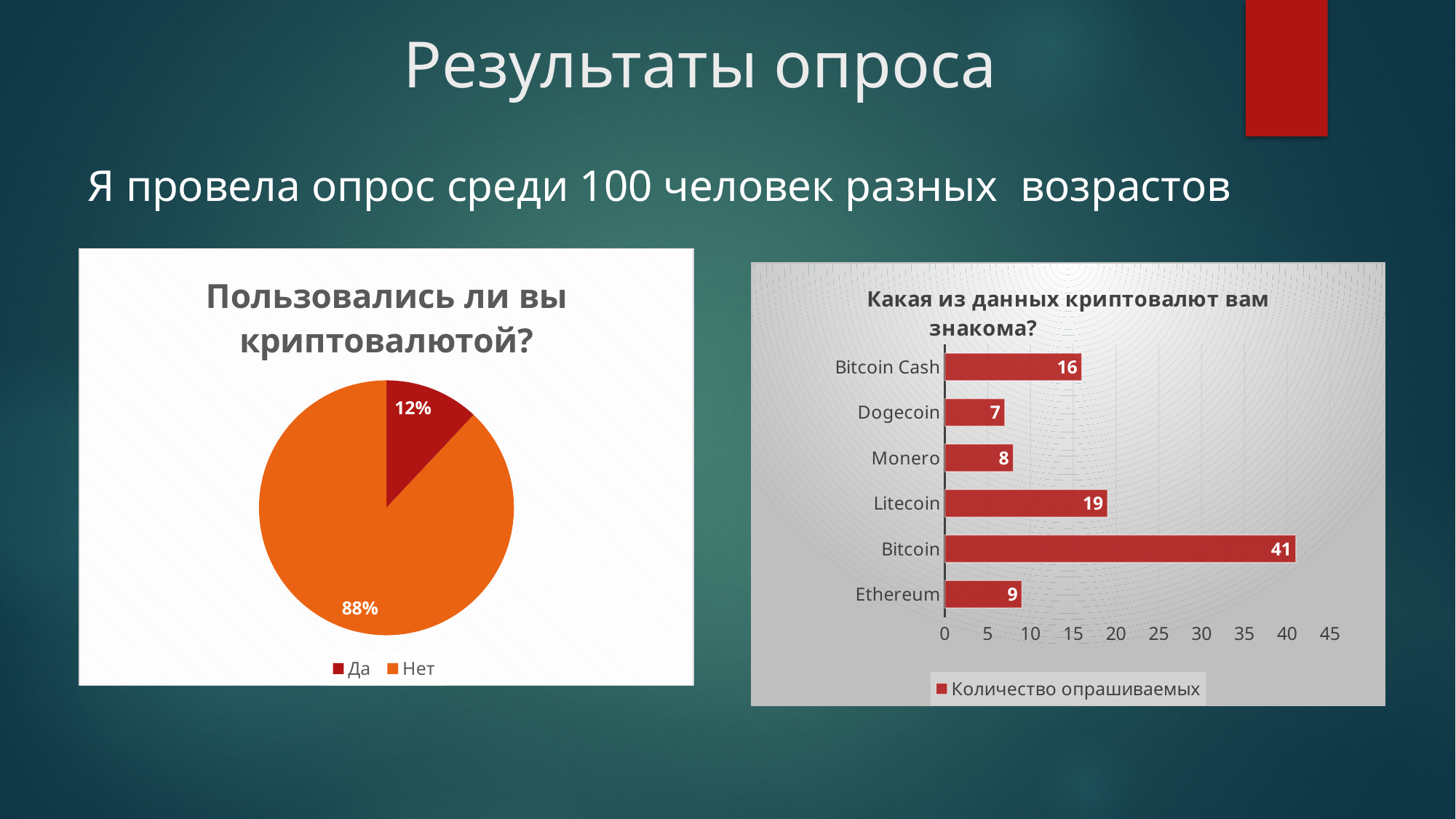
In the pie chart 'Пользовались ли вы криптовалютой?', what share of respondents answered 'Нет'? 88% In the pie chart 'Пользовались ли вы криптовалютой?', which answer has the larger slice, 'Да' or 'Нет'? Нет In the bar chart 'Какая из данных криптовалют вам знакома?', which cryptocurrency has the highest value? Bitcoin In the pie chart 'Пользовались ли вы криптовалютой?', what share of respondents answered 'Да'? 12% What type of chart is the right chart 'Какая из данных криптовалют вам знакома?'? bar chart What type of chart is the left chart 'Пользовались ли вы криптовалютой?'? pie chart In the bar chart 'Какая из данных криптовалют вам знакома?', what is the value for Bitcoin? 41 How many cryptocurrencies are listed in the bar chart 'Какая из данных криптовалют вам знакома?'? 6 In the bar chart 'Какая из данных криптовалют вам знакома?', what is the value for Litecoin? 19 What is the legend entry of the bar chart 'Какая из данных криптовалют вам знакома?'? Количество опрашиваемых In the bar chart 'Какая из данных криптовалют вам знакома?', which cryptocurrency has the lowest value? Dogecoin In the bar chart 'Какая из данных криптовалют вам знакома?', what is the difference between the values for Bitcoin and Bitcoin Cash? 25